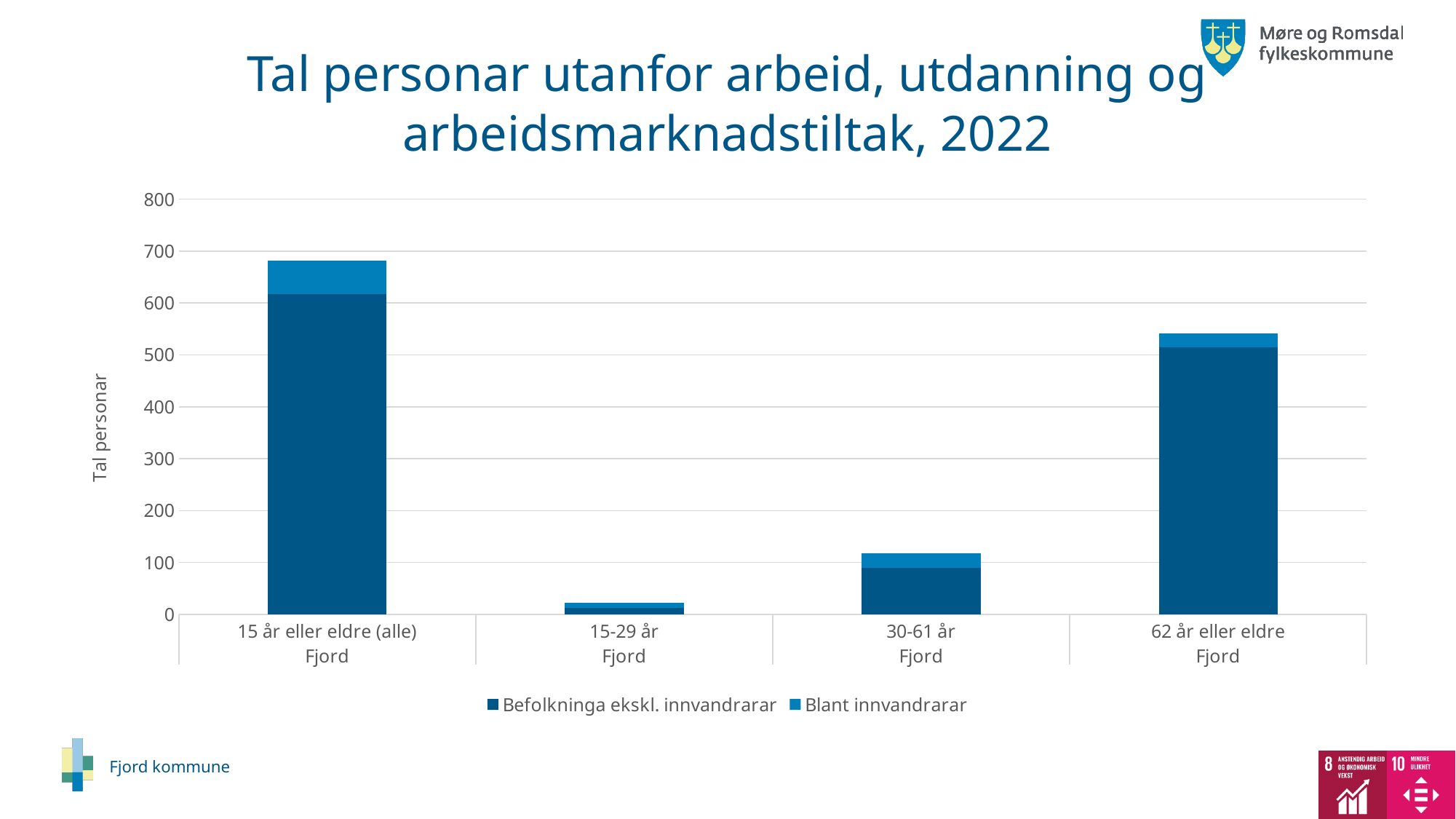
What is the label on the vertical axis? Tal personar Which category has the shortest stacked bar? 15-29 år Is the total value for 30-61 år greater or less than 200? less Is the total value for 15 år eller eldre (alle) greater or less than 600? greater Is the total value for 15-29 år greater or less than 100? less Which category has the tallest stacked bar? 15 år eller eldre (alle) How many series does the legend list? 2 How many categories are shown on the x axis? 4 What are the two series named in the legend? Befolkninga ekskl. innvandrarar; Blant innvandrarar What kind of chart is shown on the slide? Stacked bar chart Which stacked bar is taller: 30-61 år or 62 år eller eldre? 62 år eller eldre